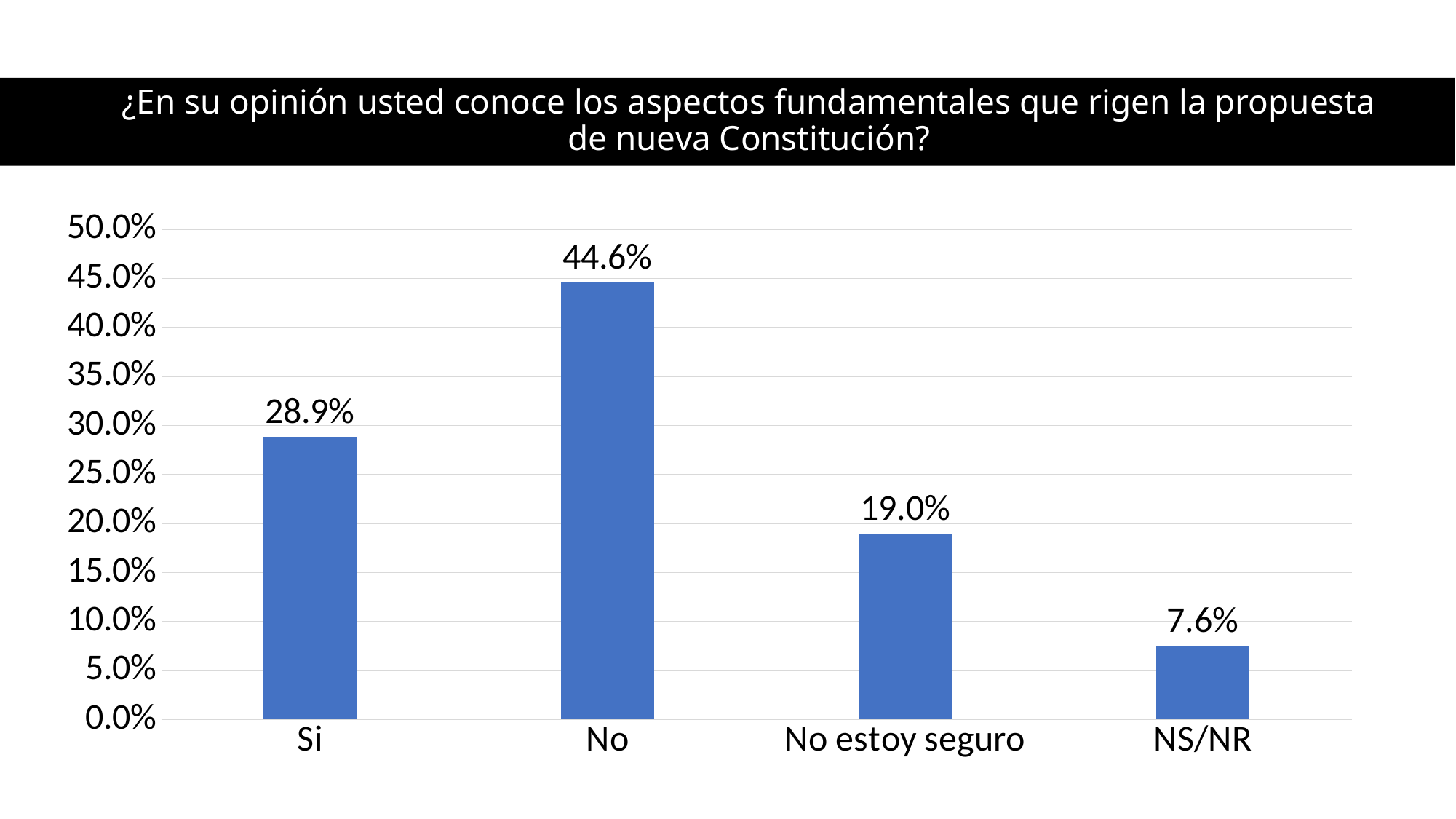
What is the difference between the values for "No estoy seguro" and "NS/NR"? 11.4% Which category has the lowest value? NS/NR Is the value for "No" greater or less than 40.0%? greater What kind of chart is shown on the slide? Bar chart What is the value for "No"? 44.6% What is the difference between the values for "No" and "Si"? 15.7% What is the value for "No estoy seguro"? 19.0% What is the value for "Si"? 28.9% How many categories are shown on the x axis? 4 Which category has the highest value? No Which is larger, the value for "Si" or the value for "No estoy seguro"? Si What is the value for "NS/NR"? 7.6%